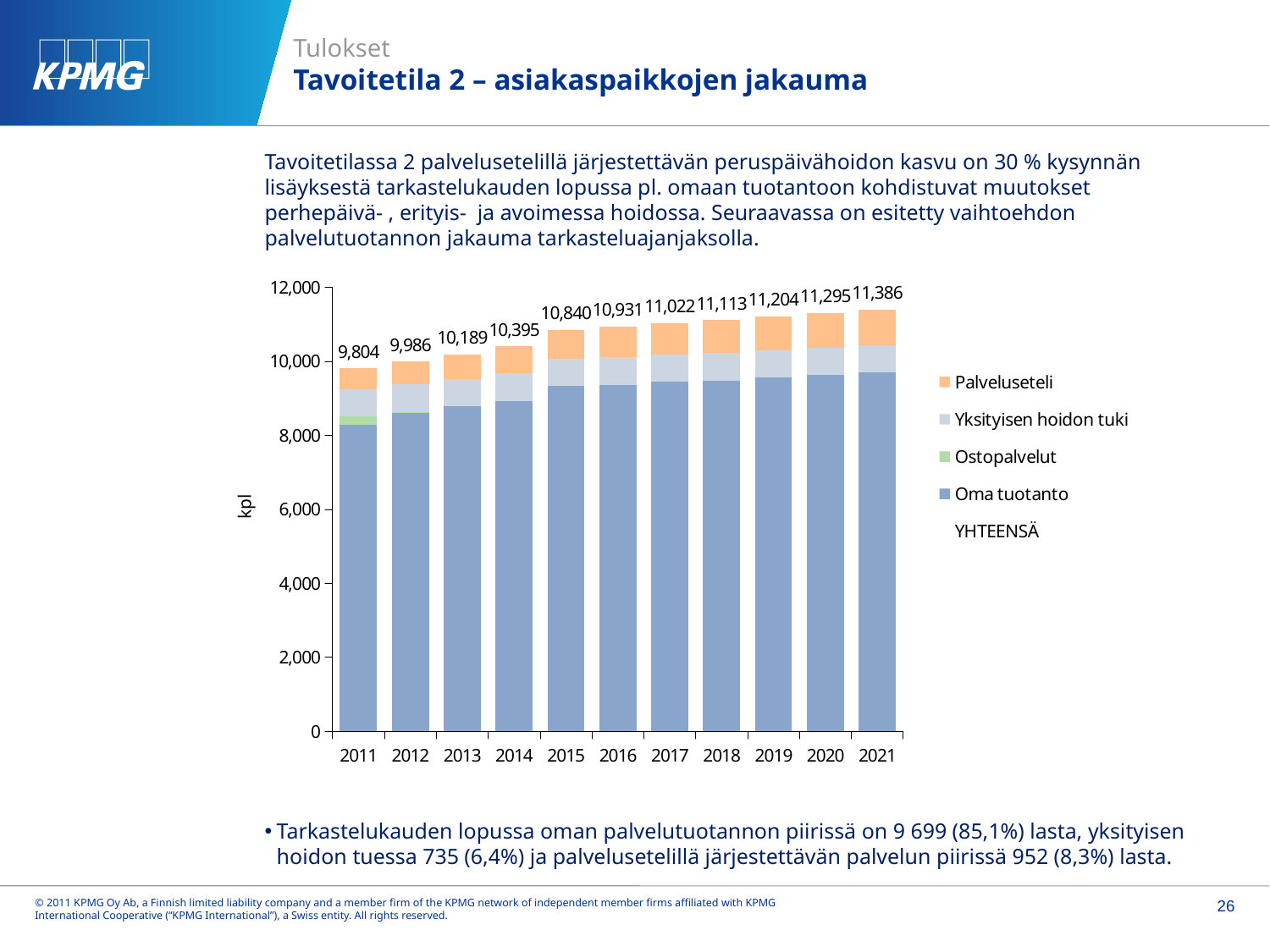
Which is larger, the total for 2014 or the total for 2015? 2015 Do the total values rise or fall from 2011 to 2021? Rise What is the total value shown above the bar for 2021? 11,386 Is the value for Oma tuotanto in 2011 greater or less than 10,000? less What is the total value shown above the bar for 2011? 9,804 How many entries does the legend list? 5 What is the total value shown above the bar for 2015? 10,840 Which year has the highest total value? 2021 What kind of chart is shown on the slide? Stacked bar chart How many years are shown on the x axis? 11 What is the difference between the total for 2021 and the total for 2011? 1,582 Which year has the lowest total value? 2011